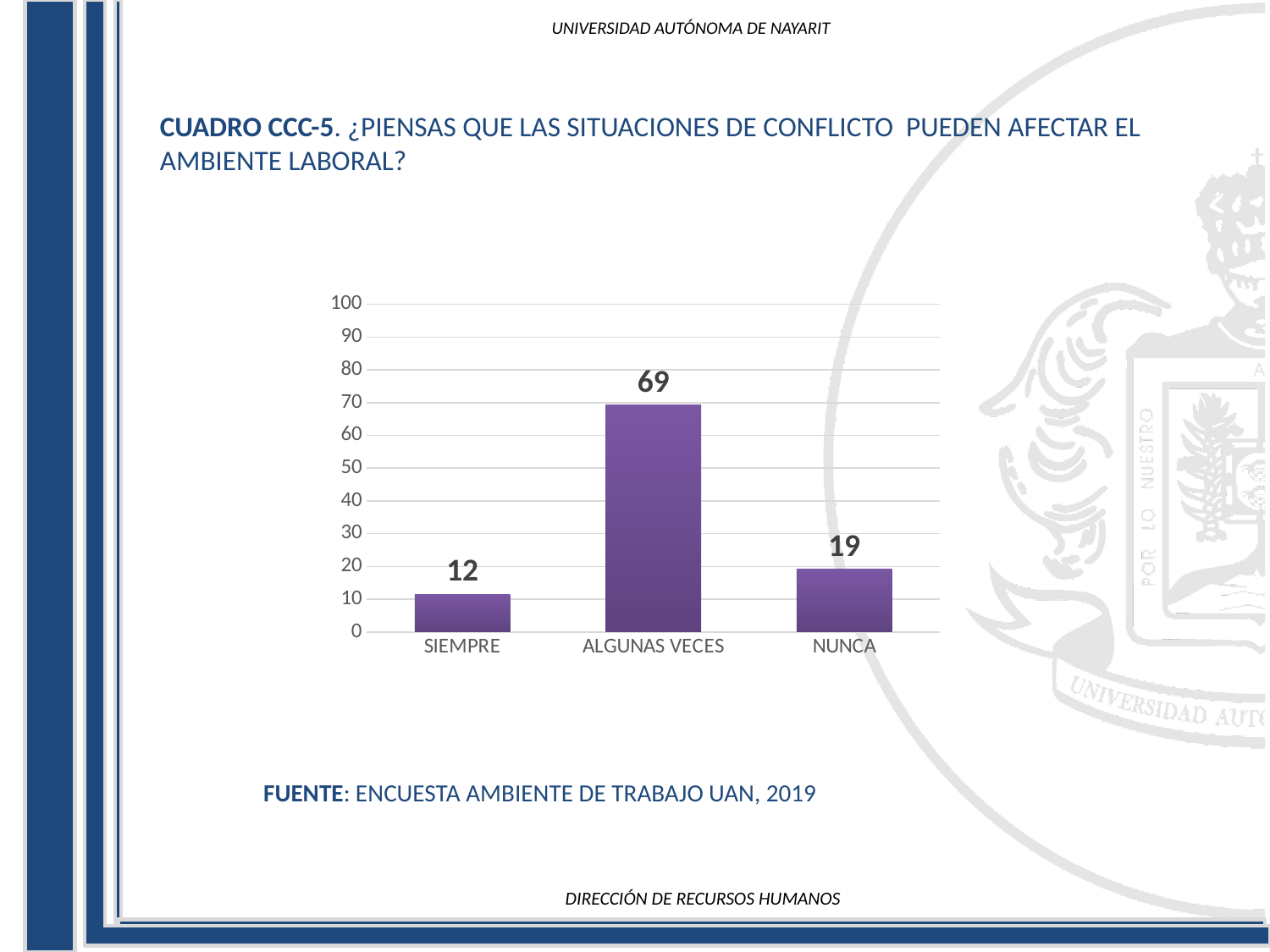
What is the value for NUNCA? 19 What kind of chart is shown on the slide? bar chart Which category has the highest value? ALGUNAS VECES Which is larger, the value for NUNCA or the value for SIEMPRE? NUNCA What is the value for SIEMPRE? 12 Is the value for ALGUNAS VECES greater or less than 50? greater Which category has the lowest value? SIEMPRE What is the source cited below the chart? ENCUESTA AMBIENTE DE TRABAJO UAN, 2019 What is the difference between the values for ALGUNAS VECES and NUNCA? 50 What is the value for ALGUNAS VECES? 69 How many categories are shown on the x axis? 3 What is the difference between the values for NUNCA and SIEMPRE? 7